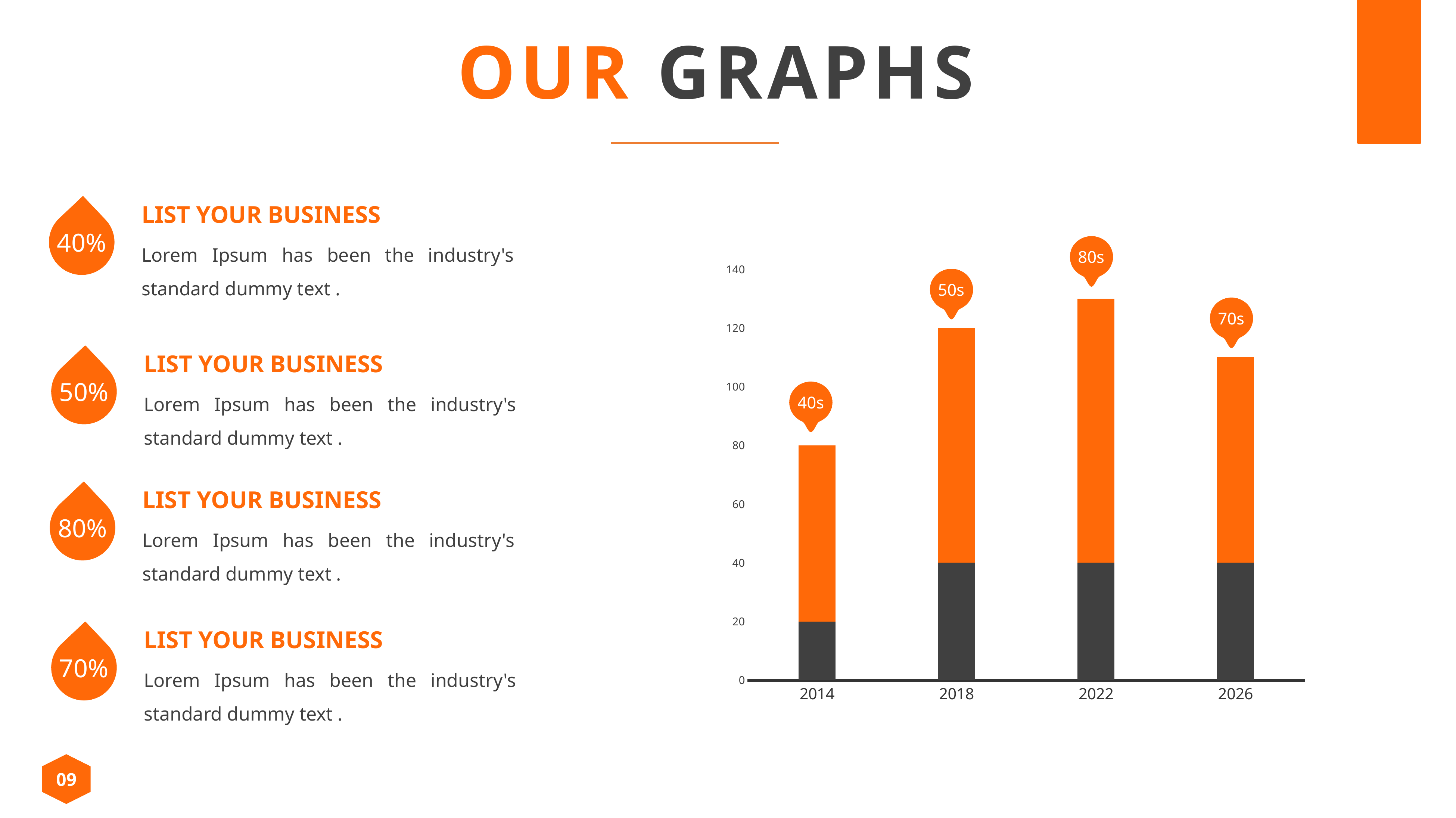
Which year has the shortest bar in the chart? 2014 Which bar is taller, 2018 or 2026? 2018 Is the total height of the bar for 2026 greater or less than 100? greater What is the total height of the bar for 2014 according to the axis? 80 Which year has the tallest bar in the chart? 2022 Is the total height of the bar for 2022 greater or less than 120? greater What kind of chart is shown on the slide? bar chart What is the total height of the bar for 2018 according to the axis? 120 Do the bar heights rise or fall from 2014 to 2022? rise How many years are shown on the x axis of the chart? 4 Is the total height of the bar for 2026 greater or less than 120? less What label is shown in the callout above the 2022 bar? 80s